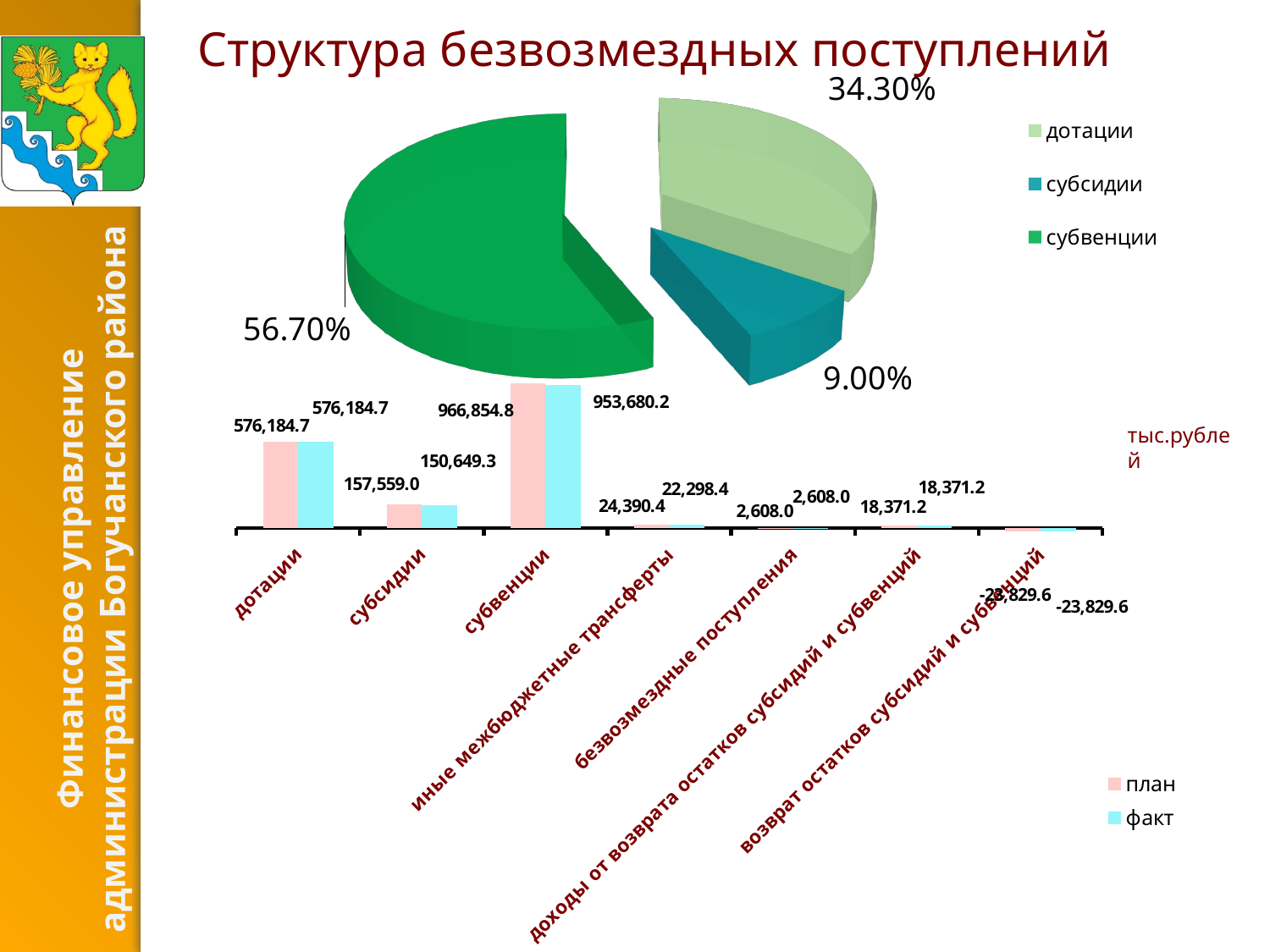
On the bar chart, what is the факт value for субвенции? 953,680.2 On the pie chart, which category has the smallest slice? субсидии How many series does the legend of the pie chart list? 3 On the bar chart, what is the факт value for возврат остатков субсидий и субвенций? -23,829.6 How many categories are shown on the bar chart? 7 On the bar chart, which category has the highest план value? субвенции On the bar chart, what is the difference between the план and факт values for иные межбюджетные трансферты? 2,092.0 On the pie chart, what share does дотации have? 34.30% On the bar chart, which is larger for субсидии: план or факт? план On the pie chart, what share does субвенции have? 56.70% On the bar chart, what is the план value for субсидии? 157,559.0 What kind of chart is the upper chart on the slide? pie chart